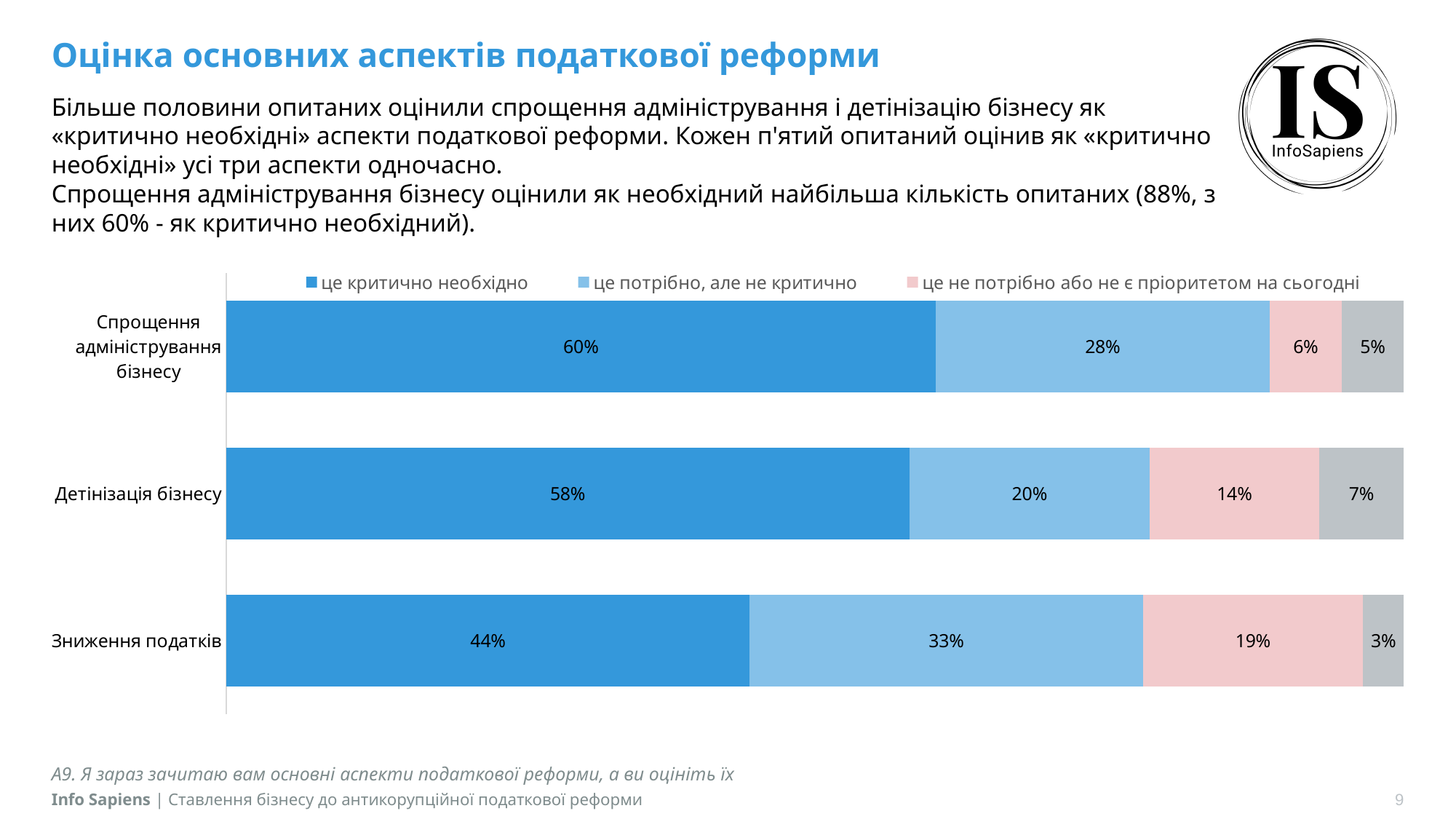
What share of respondents rated «Спрощення адміністрування бізнесу» as «це критично необхідно»? 60% What is the difference between the «це критично необхідно» shares for «Спрощення адміністрування бізнесу» and «Зниження податків»? 16 percentage points How many series does the chart legend list? 3 Which aspect has the highest share of «це критично необхідно» responses? Спрощення адміністрування бізнесу Which is larger: the «це не потрібно або не є пріоритетом на сьогодні» share for «Зниження податків» or for «Детінізація бізнесу»? Зниження податків What colour represents the «це критично необхідно» series in the chart? dark blue What kind of chart is shown on the slide? stacked bar chart Which aspect has the lowest share of «це критично необхідно» responses? Зниження податків What is the combined share of «це критично необхідно» and «це потрібно, але не критично» for «Спрощення адміністрування бізнесу»? 88% What share of respondents rated «Детінізація бізнесу» as «це не потрібно або не є пріоритетом на сьогодні»? 14% What share of respondents rated «Зниження податків» as «це потрібно, але не критично»? 33% How many categories (aspects of the tax reform) are shown in the chart? 3